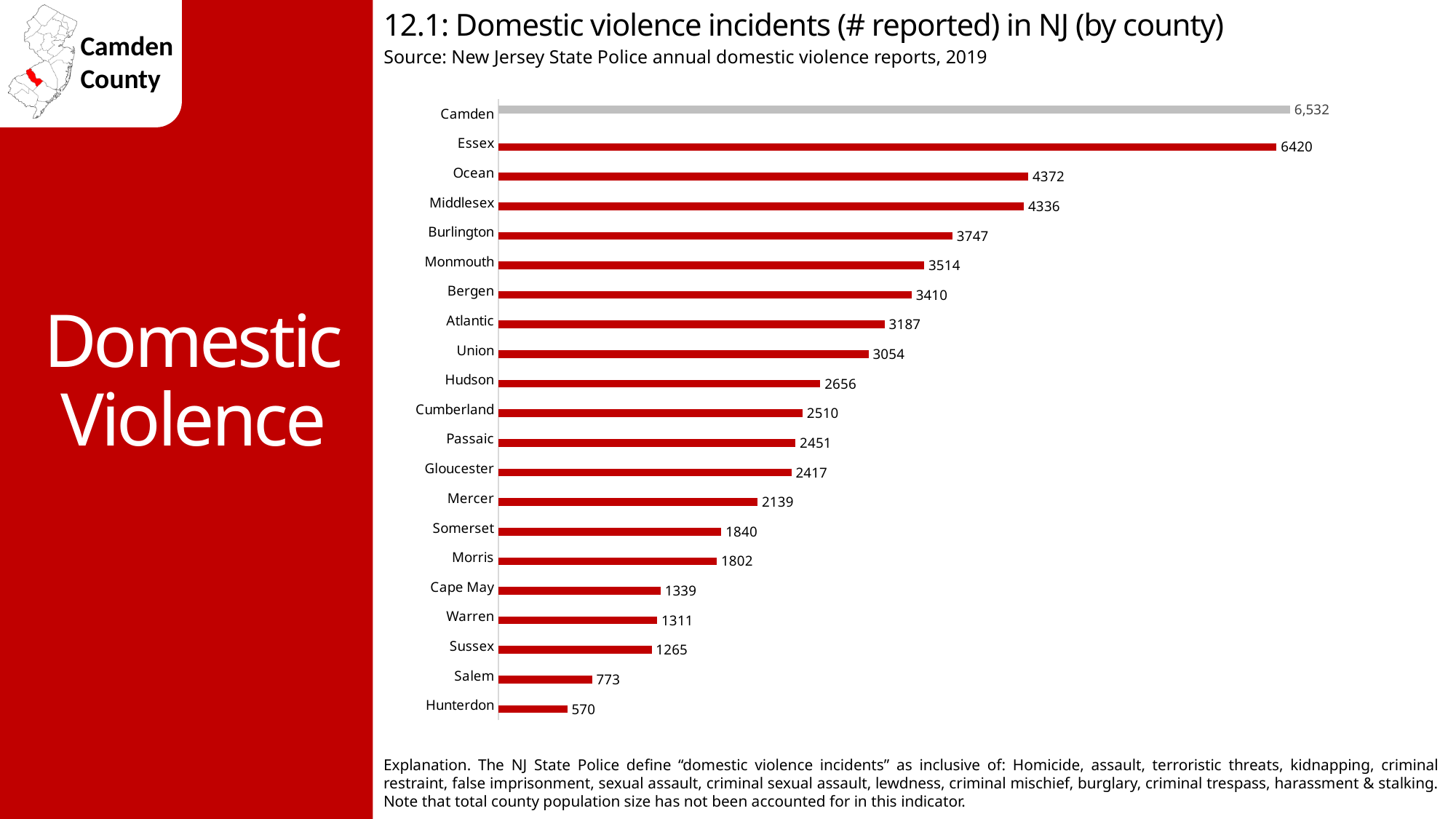
How many counties are shown in the chart? 21 What type of chart is used on this slide? Bar chart Which county has the highest number of reported domestic violence incidents? Camden Which county reported more domestic violence incidents, Monmouth or Bergen? Monmouth What is the difference between the values for Salem and Hunterdon? 203 Which county's bar is shown in a different colour (grey) from the others? Camden Which county reported more incidents, Cape May or Sussex? Cape May What is the difference between the reported incidents in Camden and Essex counties? 112 What value is shown for Hudson County? 2656 What is the number of reported domestic violence incidents for Burlington County? 3747 Which county has the lowest number of reported domestic violence incidents? Hunterdon How many domestic violence incidents were reported in Camden County? 6,532